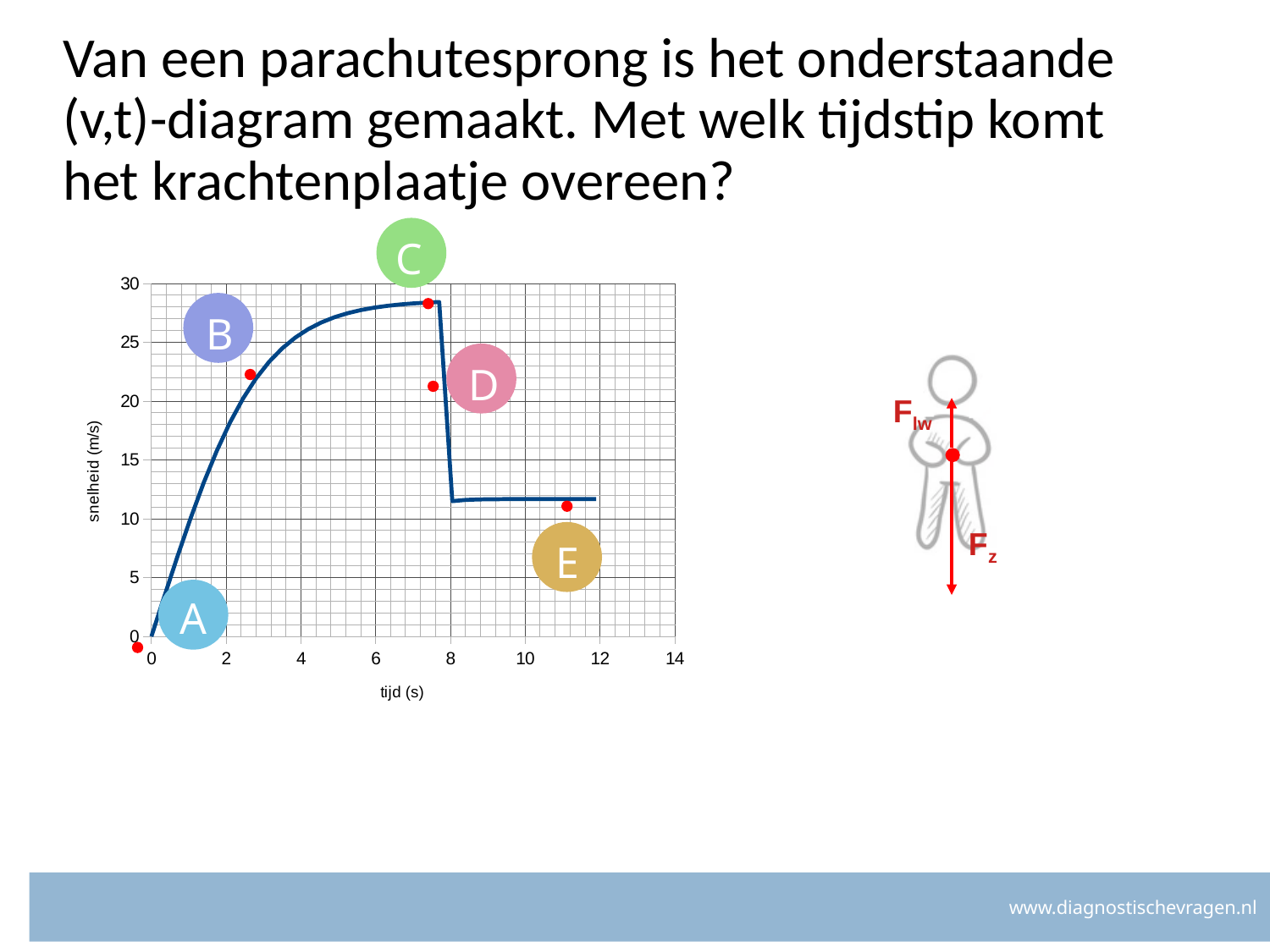
How many lettered points (A to E) are marked on the chart? 5 What is the label of the x axis of the chart? tijd (s) What is the label of the y axis of the chart? snelheid (m/s) What kind of chart is shown on the slide? line chart Is the speed at tijd 4 s greater or less than 20 m/s? greater Which lettered point marks the highest speed on the chart? C Is the speed at tijd 3 s greater or less than 20 m/s? greater Is the speed at tijd 10 s greater or less than 10 m/s? greater Which is larger, the speed at tijd 6 s or the speed at tijd 10 s? tijd 6 s Does the speed rise or fall between tijd 0 s and tijd 6 s? rise